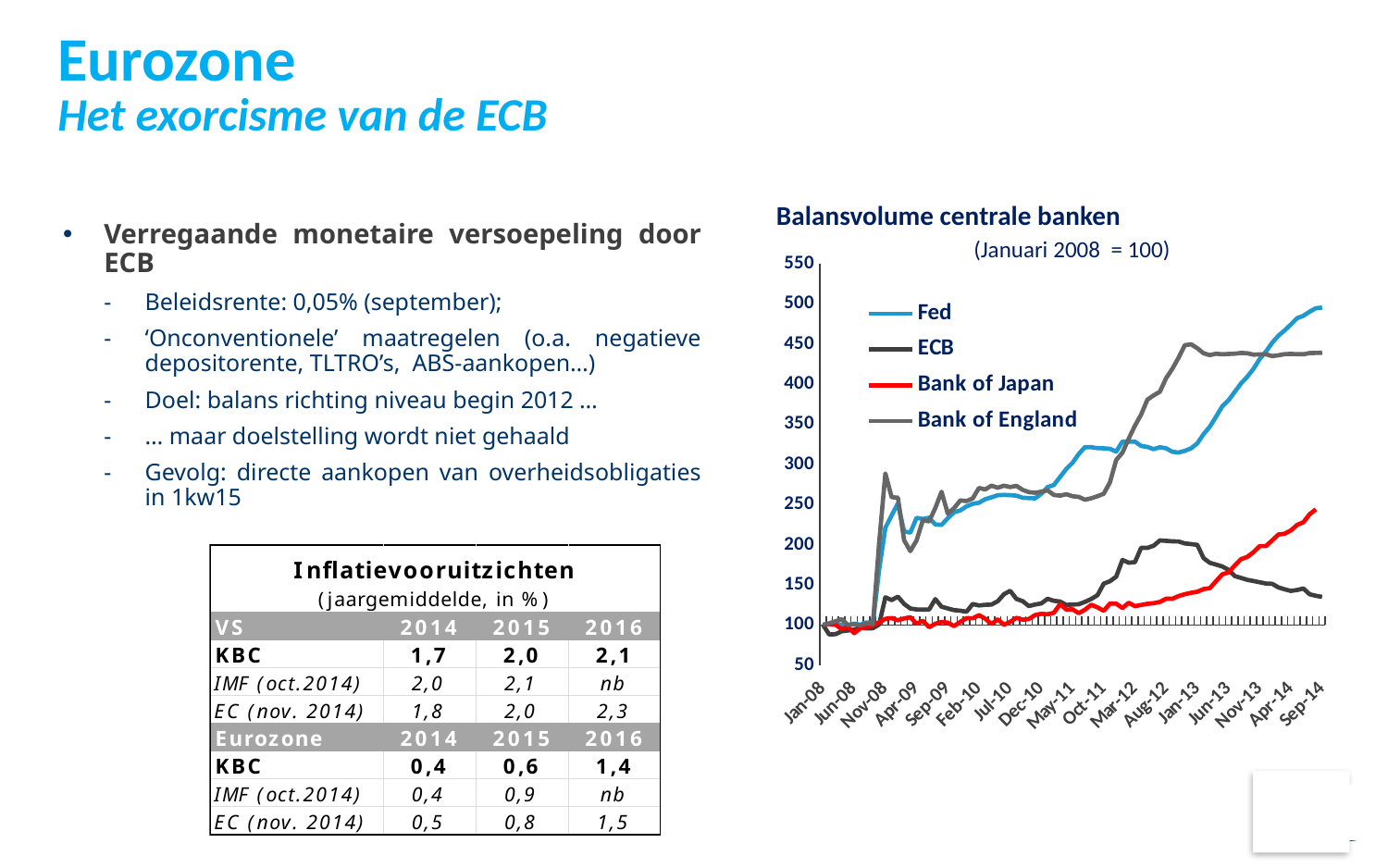
Is the value for the ECB at Sep-14 greater or less than 150? less How many series does the legend of the 'Balansvolume centrale banken' chart list? 4 Is the value for the Bank of England at Sep-14 greater or less than 400? greater Which central banks are listed in the legend of the chart? Fed, ECB, Bank of Japan, Bank of England Is the value for the Fed at Sep-14 greater or less than 450? greater What kind of chart is shown on the slide? line chart What base period is the index in the chart set to 100? Januari 2008 Does the Fed series rise or fall overall from Jan-08 to Sep-14? rise Which series has the highest value at Sep-14 in the chart? Fed Which series has the lowest value at Sep-14 in the chart? ECB